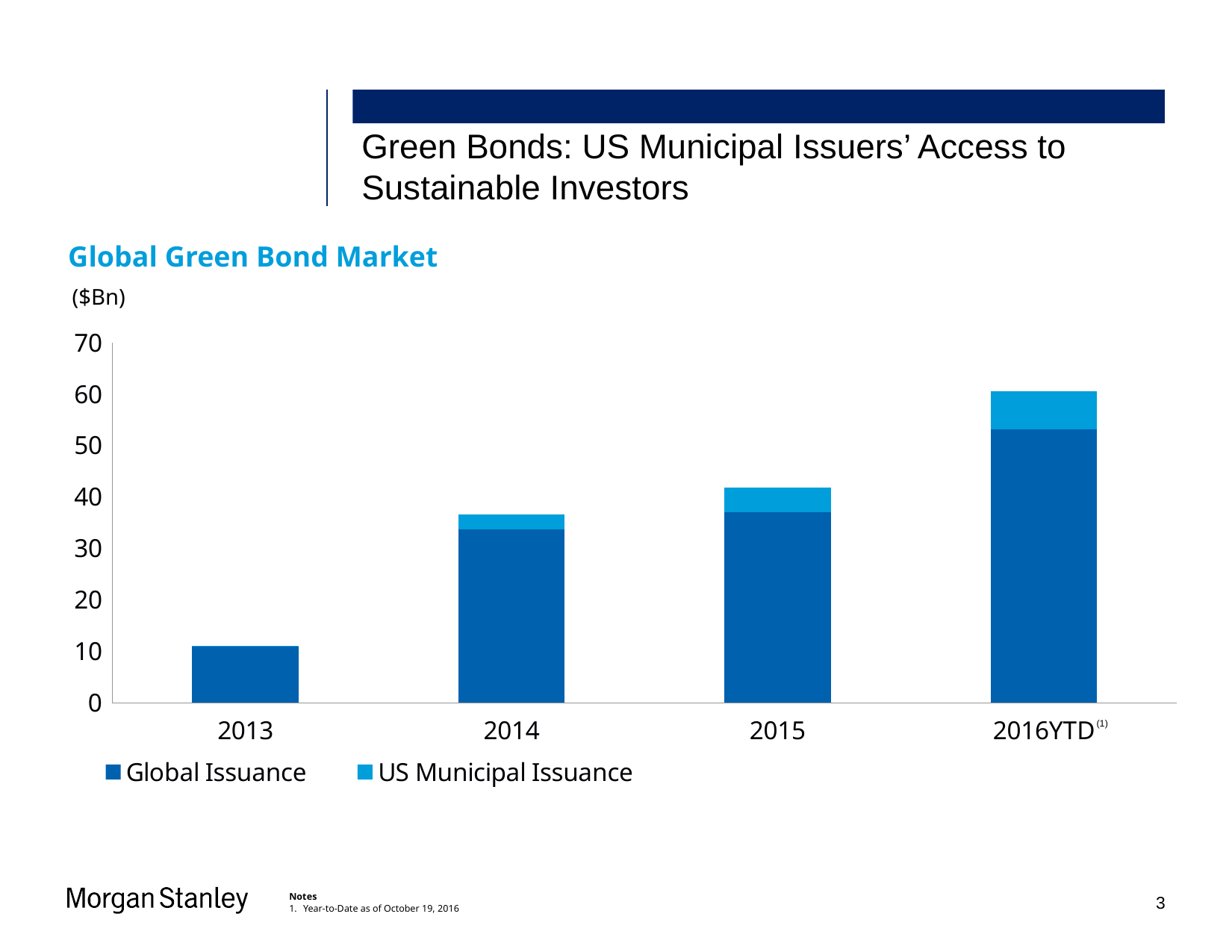
Which year has the highest total bar? 2016YTD How many series does the legend list? 2 Is the total bar for 2016YTD greater or less than 50? greater What unit is shown for the chart's values? $Bn Is the total bar for 2015 greater or less than 50? less Which year has the lowest total bar? 2013 What kind of chart is shown on the slide? stacked bar chart Do the total bar heights rise or fall from 2013 to 2016YTD? rise Which is larger, the total bar for 2014 or the total bar for 2015? 2015 Is the Global Issuance value for 2014 greater or less than 30? greater How many categories are shown on the x axis? 4